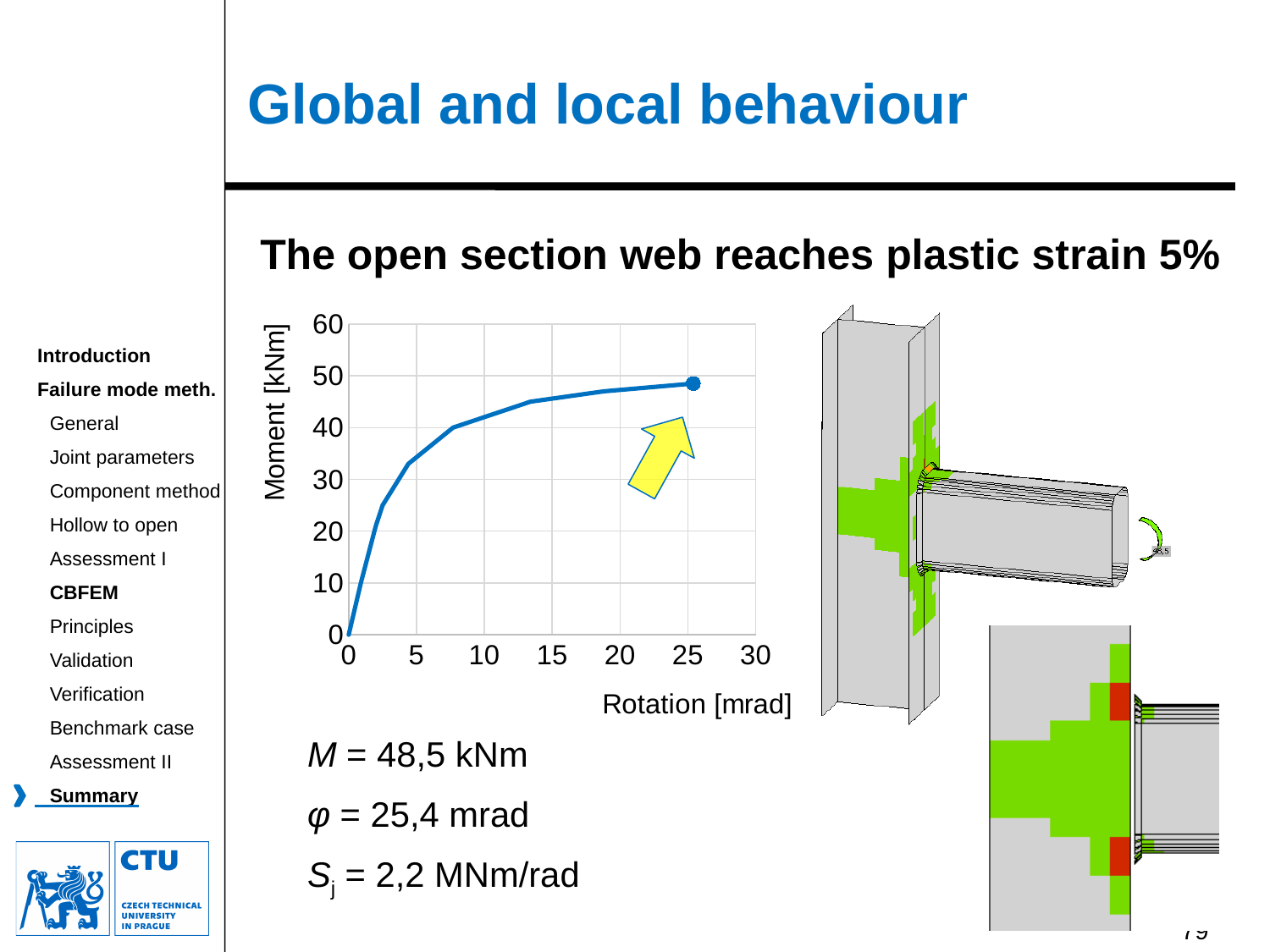
What is the label of the y axis of the chart? Moment [kNm] How many lines are plotted on the chart? 1 What type of chart is shown on the slide? line chart What is the label of the x axis of the chart? Rotation [mrad] Is the moment at a rotation of 20 mrad greater or less than 50 kNm? less What is the highest tick value shown on the x axis of the chart? 30 What is the rotation φ at the marked end point of the curve, as stated on the slide? 25,4 mrad What is the moment M at the marked end point of the curve, as stated on the slide? 48,5 kNm Is the moment at a rotation of 5 mrad greater or less than 40 kNm? less Is the moment at a rotation of 5 mrad greater or less than 30 kNm? greater Does the moment rise or fall as rotation increases along the x axis? rise What is the highest tick value shown on the y axis of the chart? 60